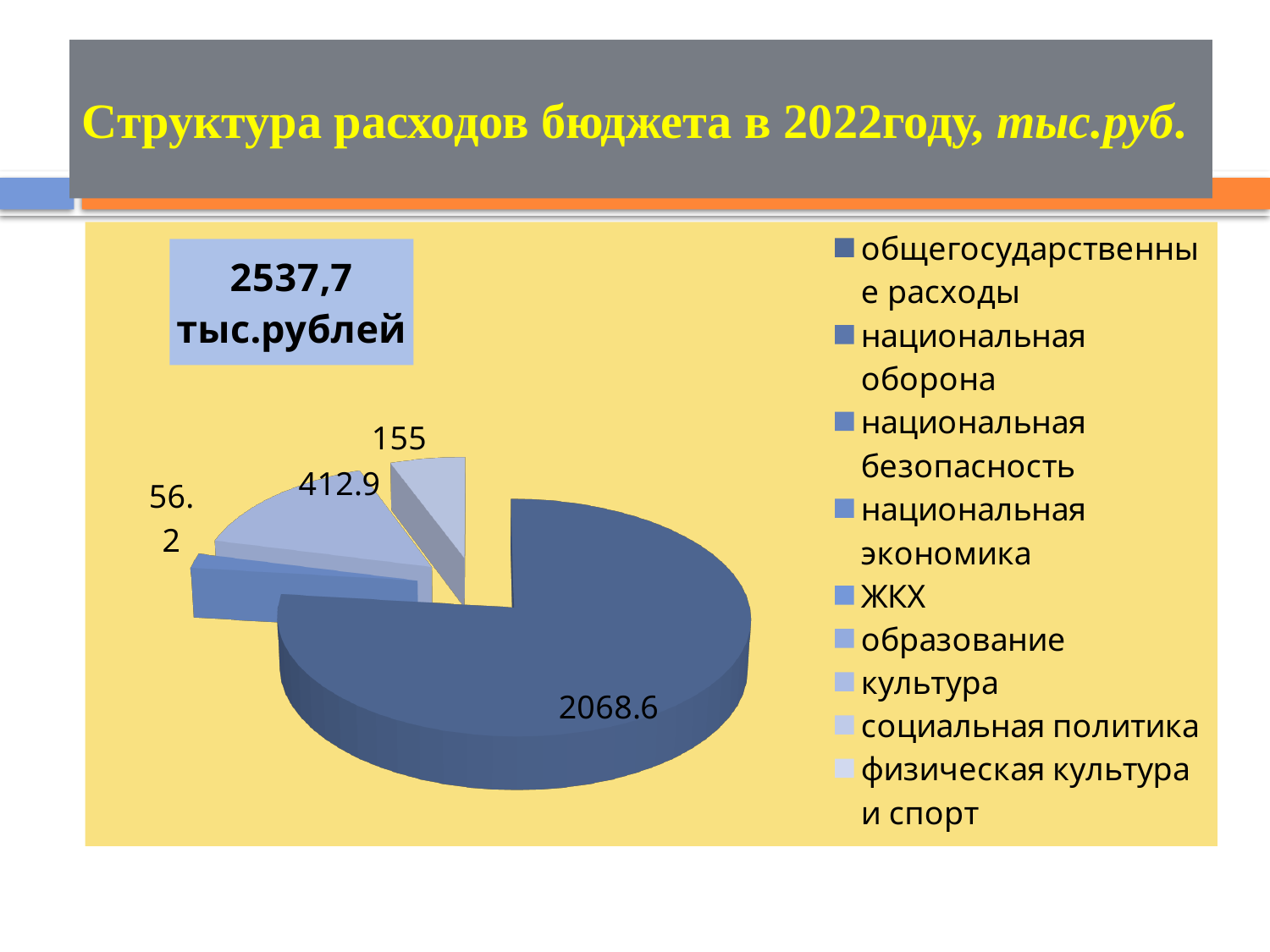
What kind of chart is shown on the slide? pie chart What is the difference between the slices labelled 155 and 56.2? 98.8 What is the value of the largest slice in the pie chart? 2068.6 Which legend entry corresponds to the largest, darkest slice of the pie chart? общегосударственные расходы What is the difference between the slices labelled 412.9 and 155? 257.9 What is the value of the smallest labelled slice in the pie chart? 56.2 What total amount is shown in the text box on the chart? 2537,7 тыс.рублей What is the difference between the largest slice (2068.6) and the slice labelled 412.9? 1655.7 How many slices with data labels are visible in the pie chart? 4 What is the title of the slide's chart? 2537,7 тыс.рублей Which slice is larger: the one labelled 412.9 or the one labelled 155? 412.9 How many entries does the chart's legend list? 9